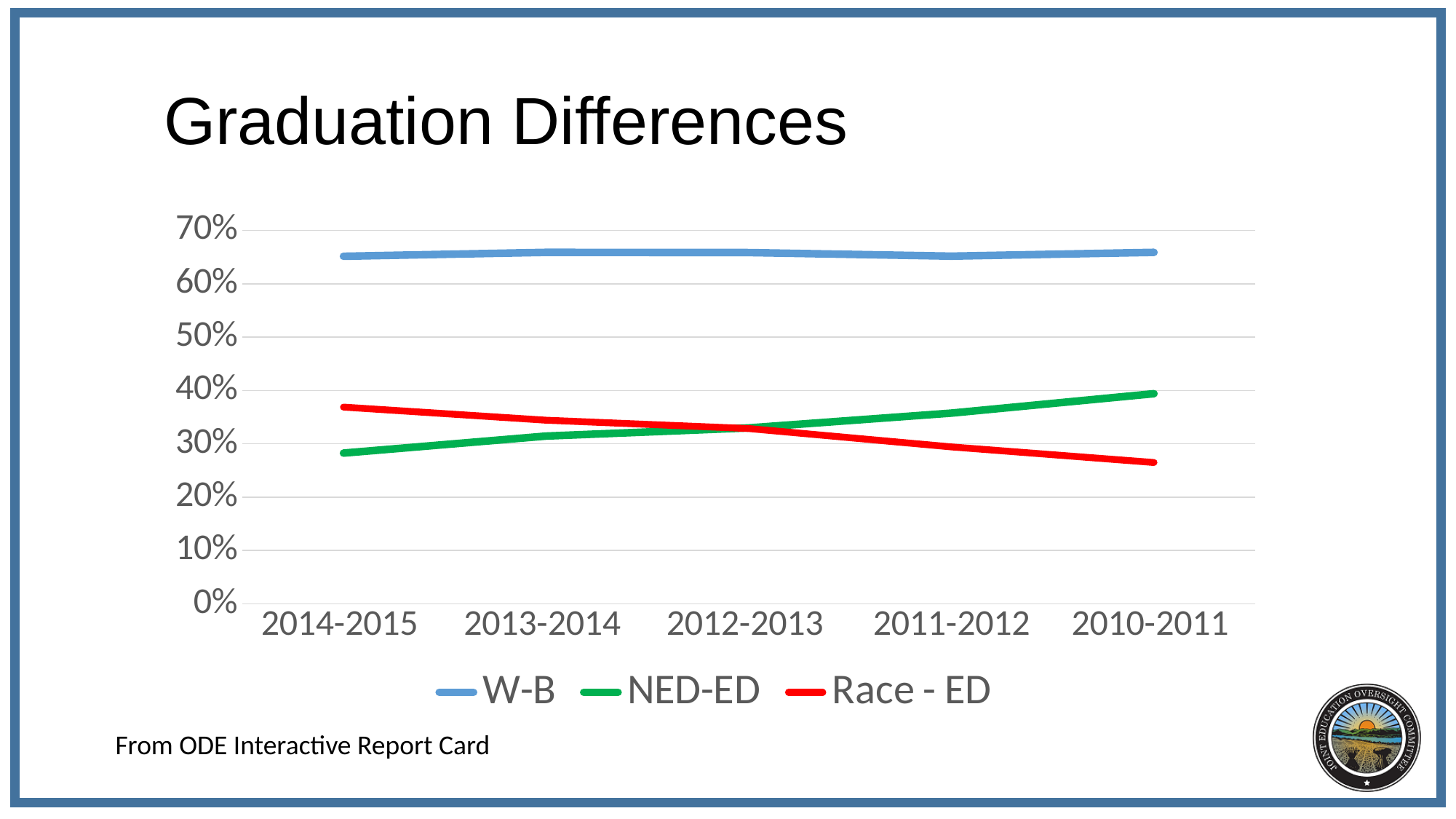
Is the value for Race - ED in 2010-2011 greater or less than 30%? less Is the value for W-B in 2014-2015 greater or less than 60%? greater In 2014-2015, which is larger, NED-ED or Race - ED? Race - ED Is the value for NED-ED in 2014-2015 greater or less than 30%? less In 2010-2011, which is larger, NED-ED or Race - ED? NED-ED How many school-year categories are shown on the x axis? 5 How many series does the legend list? 3 Does the Race - ED line rise or fall moving left to right along the x axis? fall What kind of chart is shown on the slide? line chart What is the title of the chart? Graduation Differences Does the NED-ED line rise or fall moving left to right along the x axis? rise